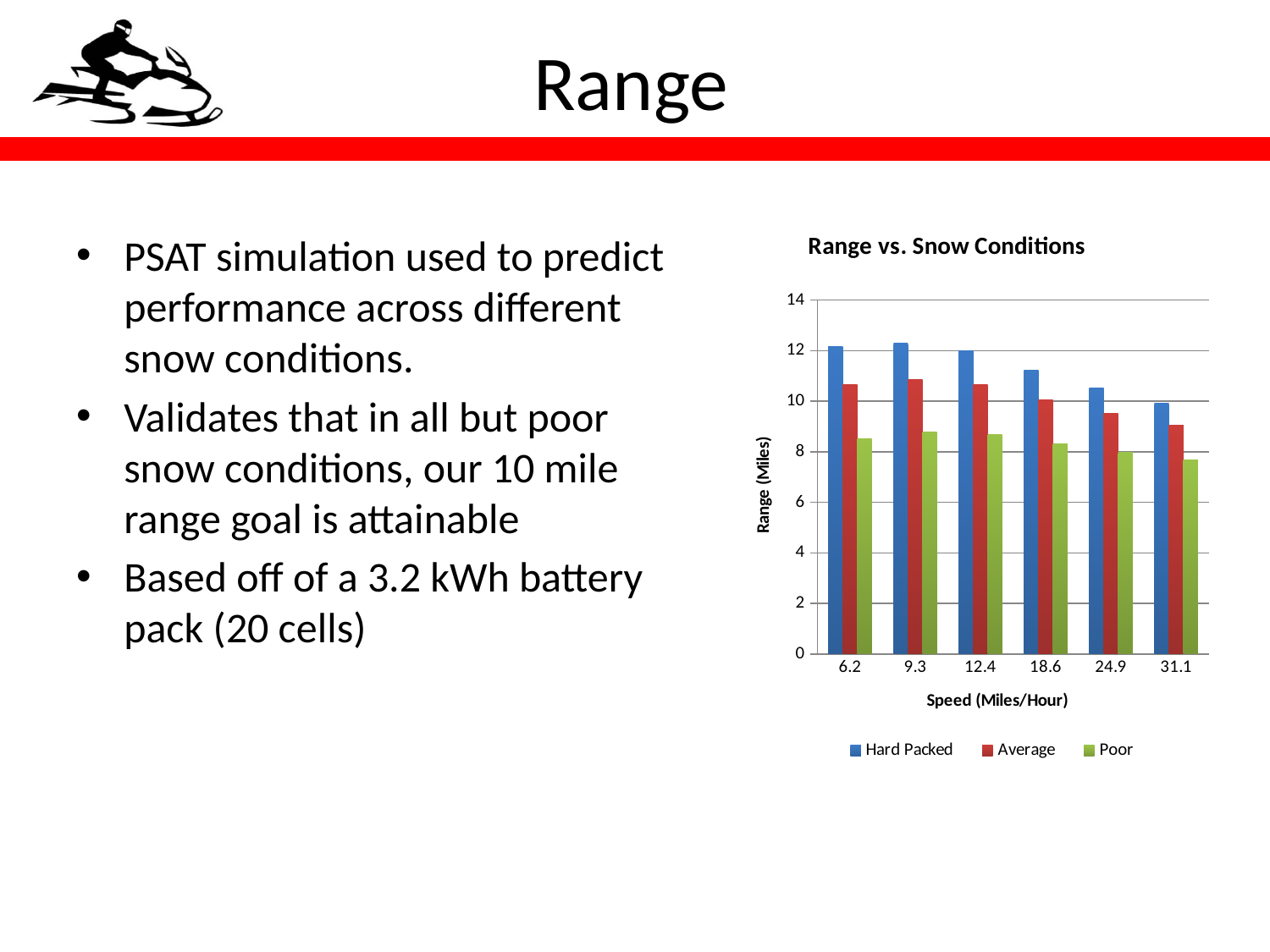
How many series does the legend of the chart list? 3 At 24.9 miles/hour, which series has the larger value, Hard Packed or Poor? Hard Packed Is the Hard Packed value at 18.6 miles/hour greater or less than 10? greater Is the Poor value at 31.1 miles/hour greater or less than 8? less What is the title of the chart? Range vs. Snow Conditions Do the Hard Packed values rise or fall from 12.4 to 31.1 miles/hour? fall How many speed categories are shown on the x axis of the chart? 6 Is the Average value at 6.2 miles/hour greater or less than 10? greater What is the label of the y axis of the chart? Range (Miles) What type of chart is shown on the slide? bar chart At which speed is the Poor series lowest? 31.1